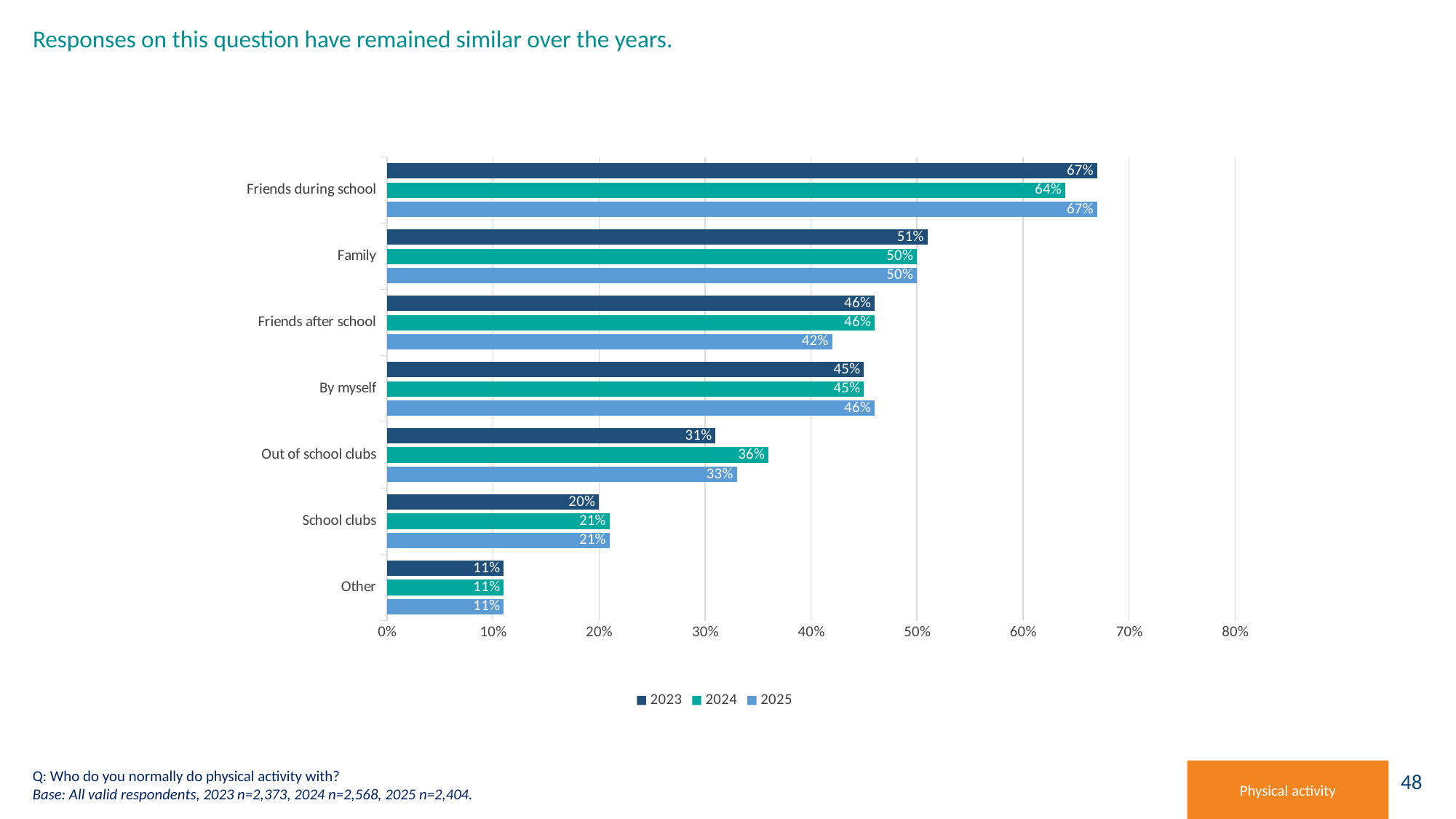
What is the difference between the 2024 and 2023 values for Out of school clubs? 5% What is the value for Family in 2023? 51% How many categories are shown on the chart? 7 How many series does the legend list? 3 Is the value for School clubs in 2024 greater or less than 30%? less What kind of chart is shown on the slide? bar chart What is the value for Friends during school in 2024? 64% Which category has the highest value in 2025? Friends during school Which category has the lowest value in 2023? Other Which is larger for Friends after school: the 2023 value or the 2025 value? 2023 Which years are listed in the legend? 2023, 2024, 2025 What is the value for Out of school clubs in 2025? 33%